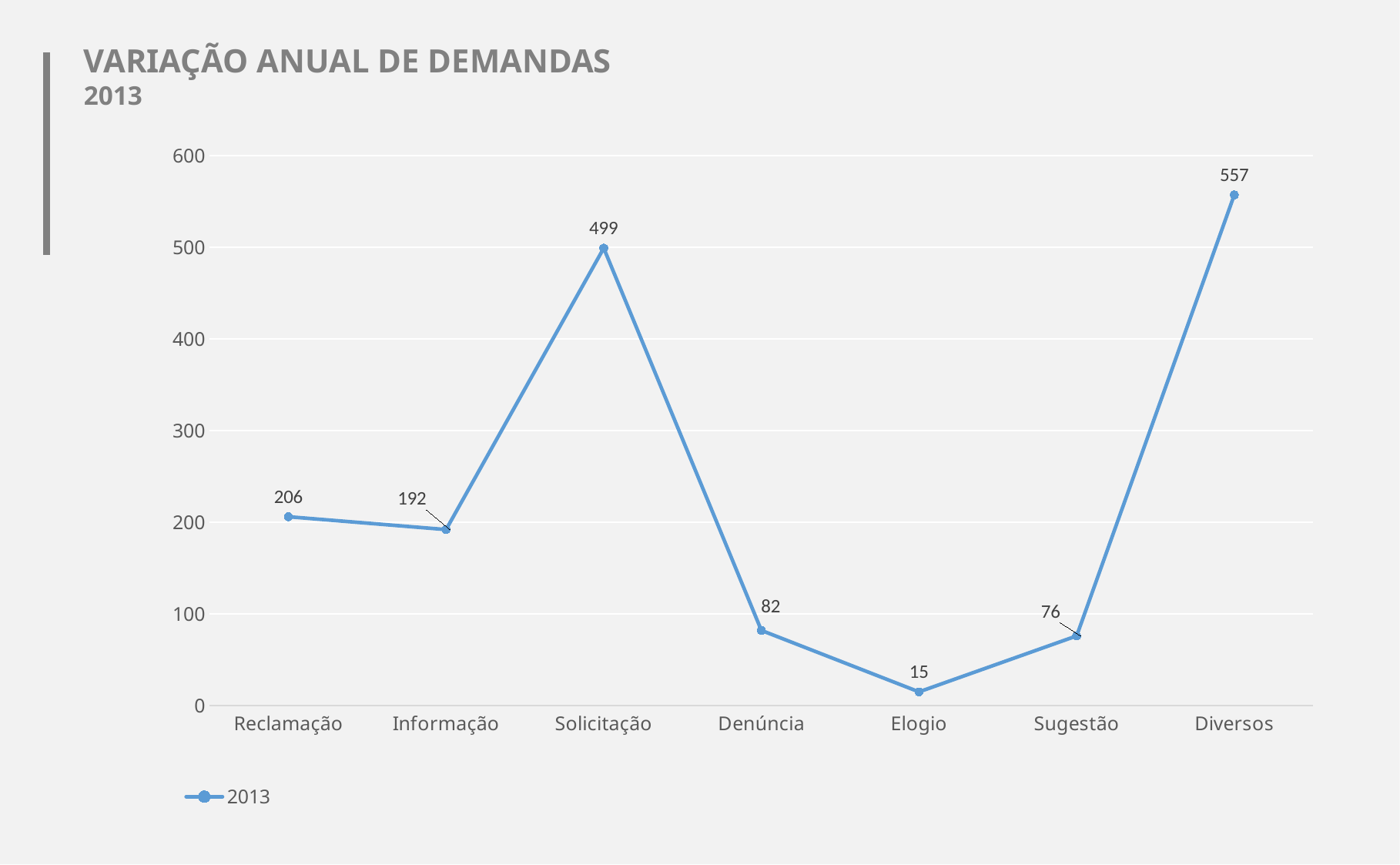
What is the value for Elogio? 15 What is the difference between the values for Reclamação and Informação? 14 What series does the legend list? 2013 What is the value for Reclamação? 206 What kind of chart is shown on the slide? line chart Which category has the highest value? Diversos How many categories are plotted on the x axis? 7 Is the value for Informação greater or less than 300? less Which is larger, the value for Denúncia or the value for Sugestão? Denúncia What is the value for Solicitação? 499 What is the difference between the values for Diversos and Solicitação? 58 Which category has the lowest value? Elogio